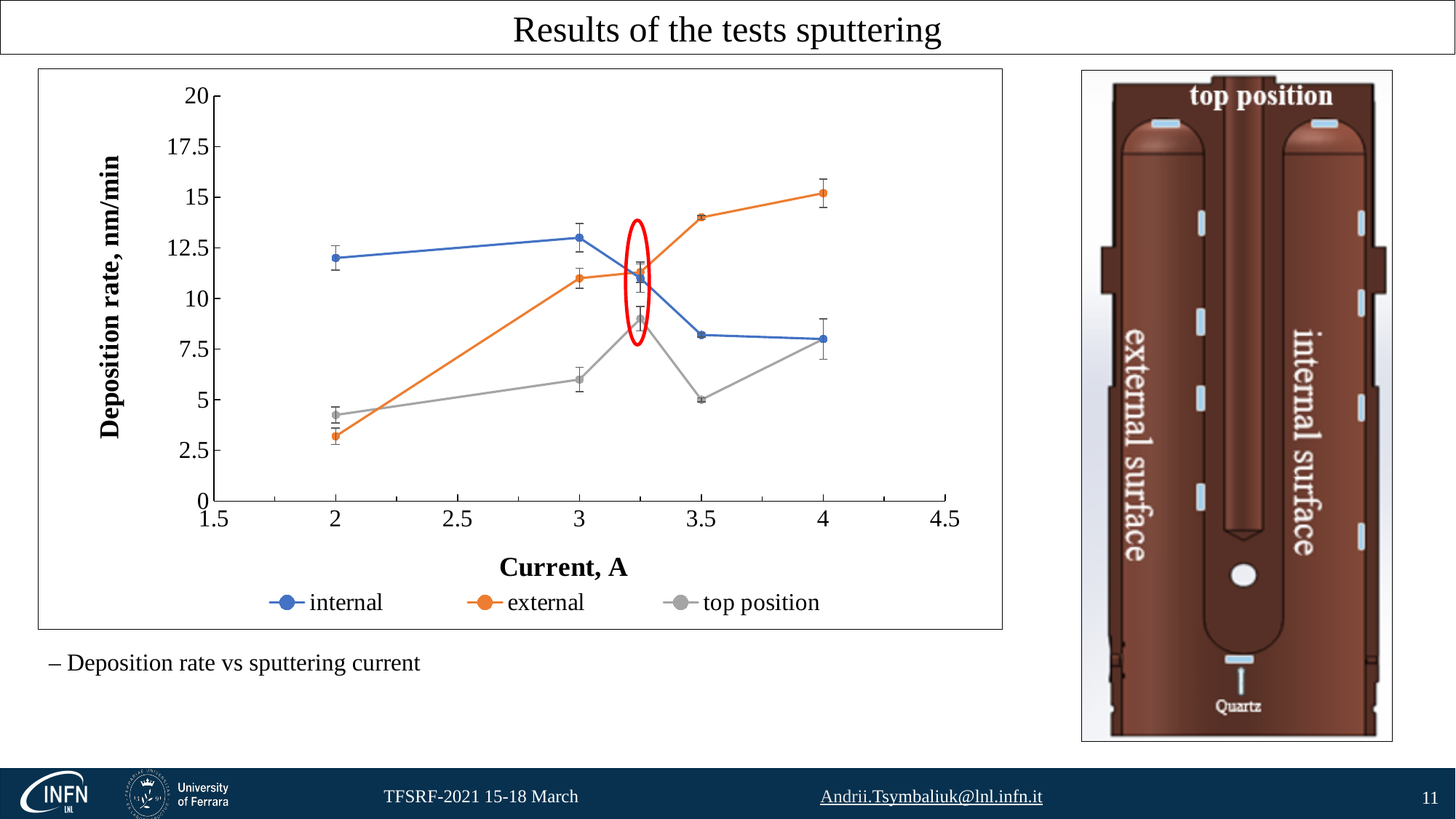
At a current of 2 A, which series has the higher deposition rate, 'internal' or 'external'? internal At which current is the 'top position' deposition rate lowest? 2 Does the 'external' deposition rate rise or fall as the current increases from 2 A to 4 A? rise At which current does the 'internal' series reach its highest deposition rate? 3 At a current of 4 A, which series has the higher deposition rate, 'internal' or 'external'? external What is the label of the x axis? Current, A How many data points does the 'external' series have? 5 At which current does the 'external' series reach its highest deposition rate? 4 How many series does the chart legend list? 3 What kind of chart is shown on the slide? line chart What is the label of the y axis? Deposition rate, nm/min Is the 'external' deposition rate at 2 A greater or less than 5 nm/min? less